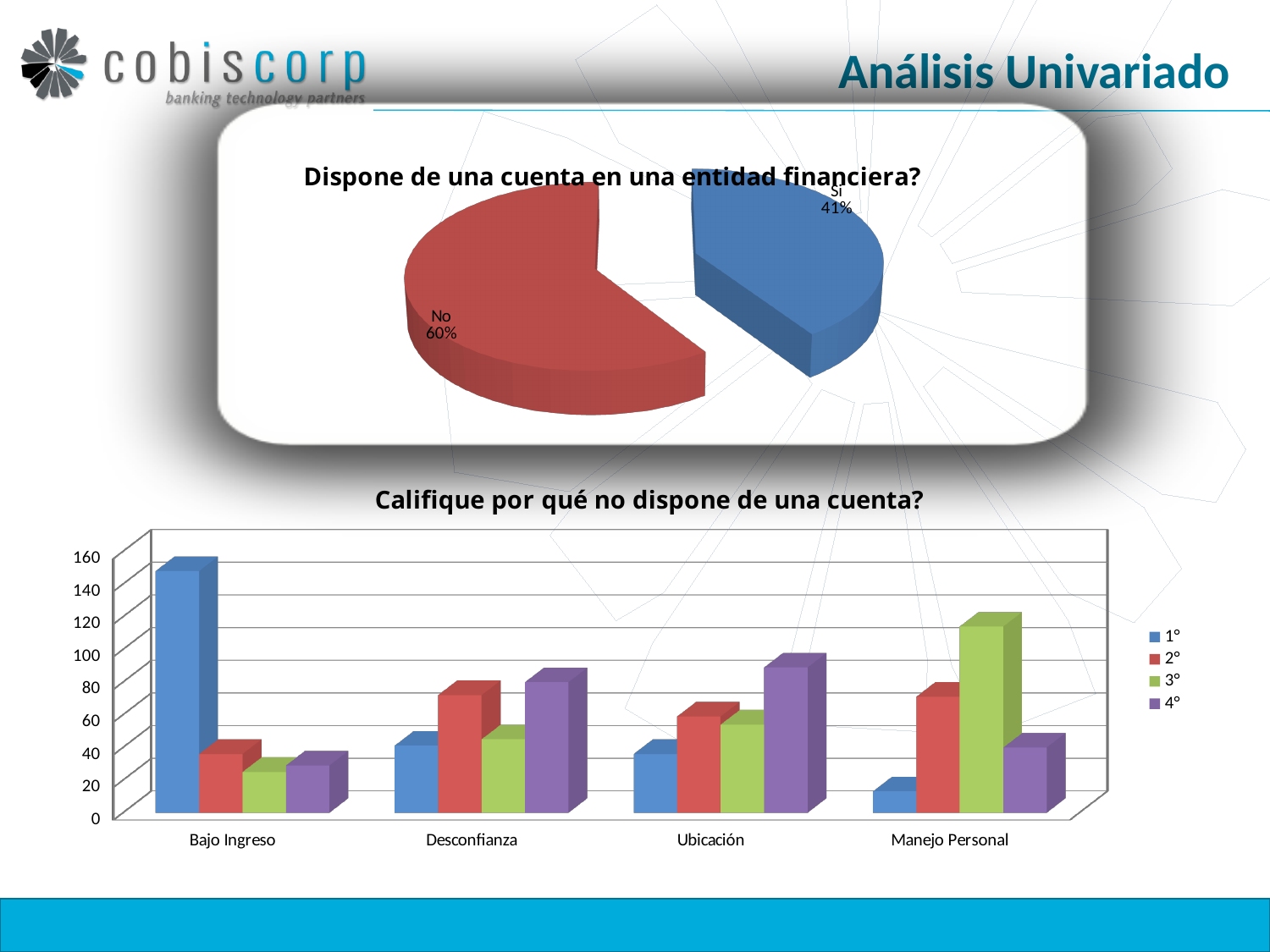
In the bar chart 'Califique por qué no dispone de una cuenta?', how many categories are shown on the x axis? 4 In the bar chart 'Califique por qué no dispone de una cuenta?', which series has the highest value for 'Bajo Ingreso'? 1° In the pie chart 'Dispone de una cuenta en una entidad financiera?', which slice is larger, 'Si' or 'No'? No In the bar chart 'Califique por qué no dispone de una cuenta?', which series has the highest value for 'Manejo Personal'? 3° In the bar chart 'Califique por qué no dispone de una cuenta?', how many series does the legend list? 4 In the bar chart 'Califique por qué no dispone de una cuenta?', is the value of series 1° for 'Manejo Personal' greater or less than 40? less In the pie chart 'Dispone de una cuenta en una entidad financiera?', how many slices are there? 2 In the pie chart 'Dispone de una cuenta en una entidad financiera?', what percentage is shown for 'No'? 60% In the pie chart 'Dispone de una cuenta en una entidad financiera?', what percentage is shown for 'Si'? 41% In the bar chart 'Califique por qué no dispone de una cuenta?', is the value of series 1° for 'Bajo Ingreso' greater or less than 120? greater What kind of chart is the bottom chart, 'Califique por qué no dispone de una cuenta?'? Bar chart What kind of chart is the top chart, 'Dispone de una cuenta en una entidad financiera?'? Pie chart